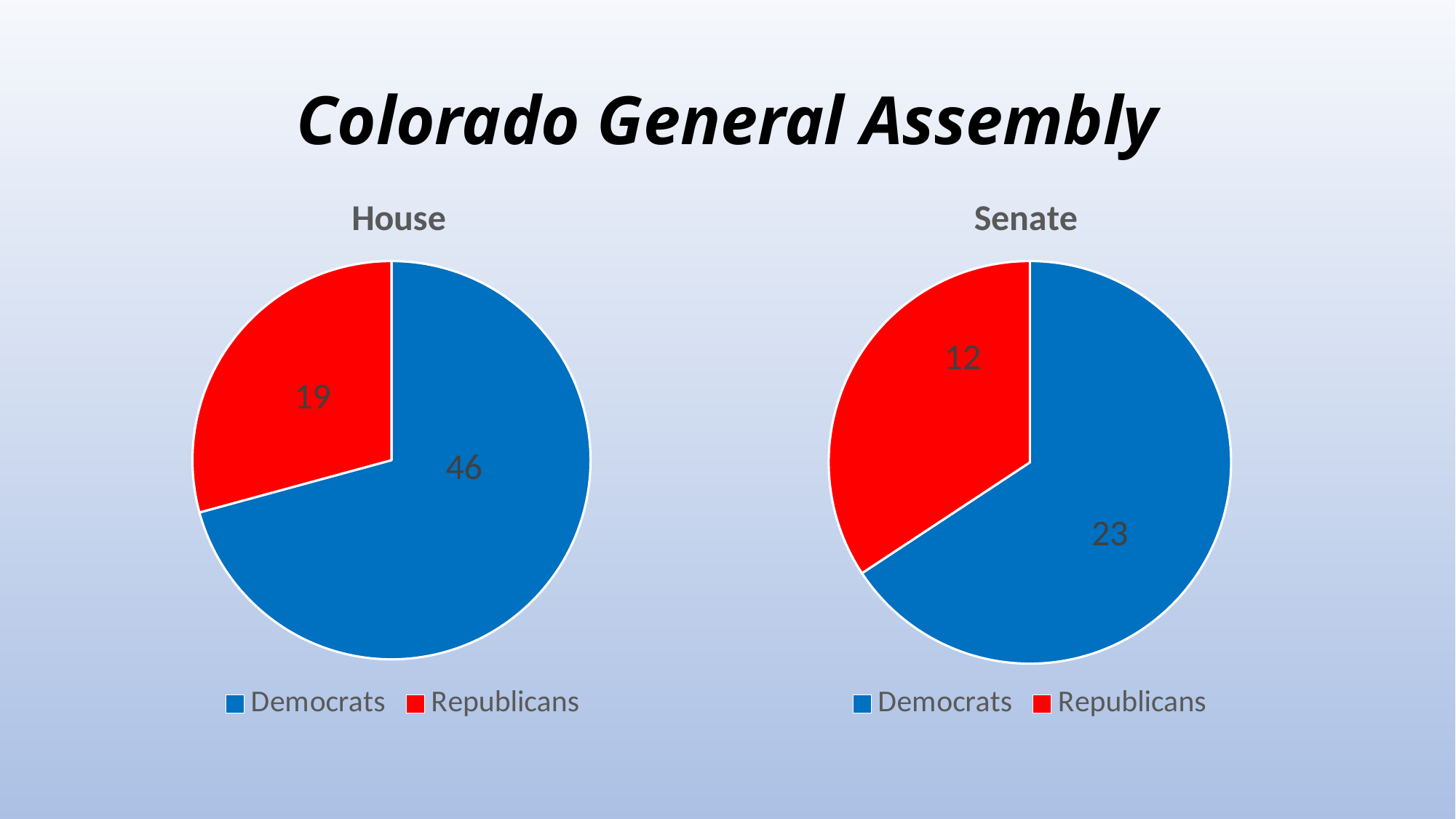
In the House chart, what is the value for Republicans? 19 In the Senate chart, what is the value for Democrats? 23 In the House chart, what is the difference between the Democrats and Republicans values? 27 What kind of chart is the Senate chart? Pie chart How many slices does the House chart have? 2 In the Senate chart, which is larger, Democrats or Republicans? Democrats In the House chart, what is the value for Democrats? 46 In the Senate chart, what is the difference between the Democrats and Republicans values? 11 What is the title of the slide above the two charts? Colorado General Assembly In the House chart, which party has the largest slice? Democrats In the Senate chart, what is the value for Republicans? 12 In the Senate chart, which party has the smallest slice? Republicans